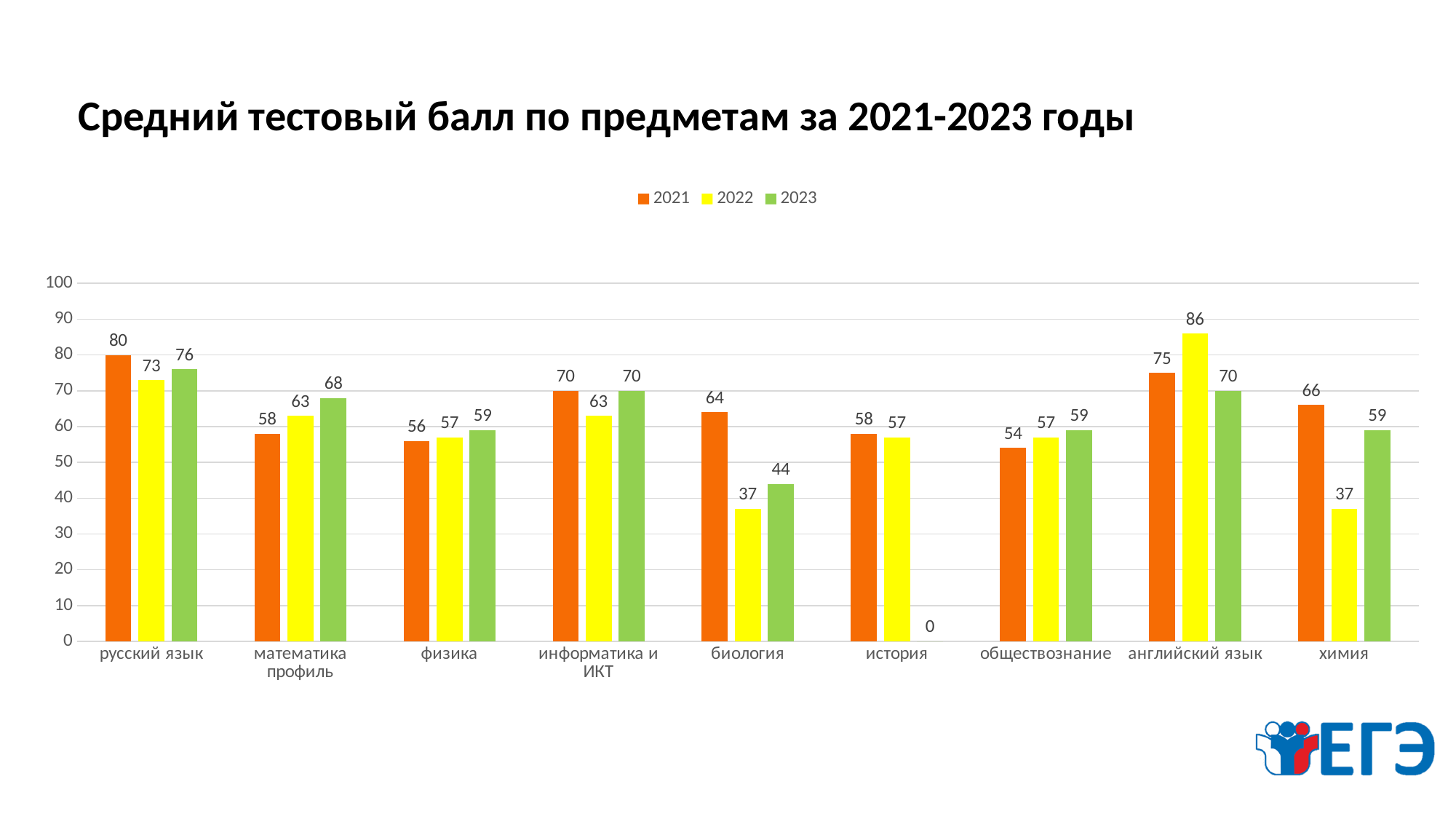
What is the title of the chart? Средний тестовый балл по предметам за 2021-2023 годы What is the value for история in the 2023 series? 0 What is the value for русский язык in the 2021 series? 80 Which category has the lowest value in the 2021 series? обществознание Which is larger for математика профиль: the 2021 value or the 2023 value? 2023 What is the difference between the 2021 and 2022 values for химия? 29 How many series does the legend list? 3 What kind of chart is shown on the slide? bar chart How many categories are shown on the x axis? 9 What is the value for биология in the 2023 series? 44 Which category has the highest value in the 2022 series? английский язык What is the value for английский язык in the 2022 series? 86